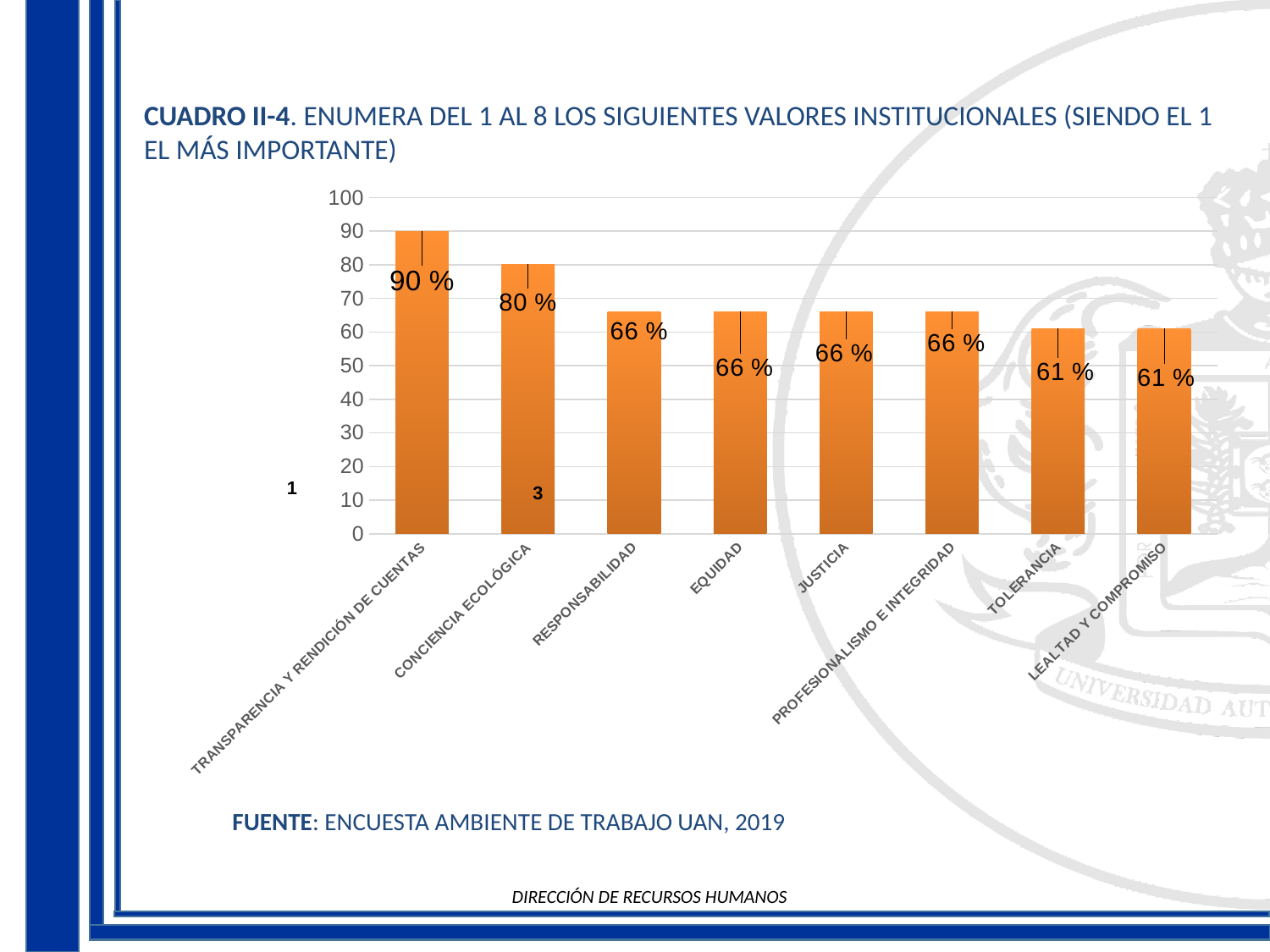
What is the value for TRANSPARENCIA Y RENDICIÓN DE CUENTAS? 90 % What kind of chart is shown on the slide? bar chart Which is larger, the value for CONCIENCIA ECOLÓGICA or the value for EQUIDAD? CONCIENCIA ECOLÓGICA How many categories are shown in the chart? 8 What is the value for CONCIENCIA ECOLÓGICA? 80 % What is the difference between the values for TRANSPARENCIA Y RENDICIÓN DE CUENTAS and CONCIENCIA ECOLÓGICA? 10 % What is the difference between the values for RESPONSABILIDAD and LEALTAD Y COMPROMISO? 5 % What source is cited below the chart? ENCUESTA AMBIENTE DE TRABAJO UAN, 2019 What is the value for TOLERANCIA? 61 % Which category has the highest value? TRANSPARENCIA Y RENDICIÓN DE CUENTAS Is the value for PROFESIONALISMO E INTEGRIDAD greater or less than 50? greater What is the value for JUSTICIA? 66 %